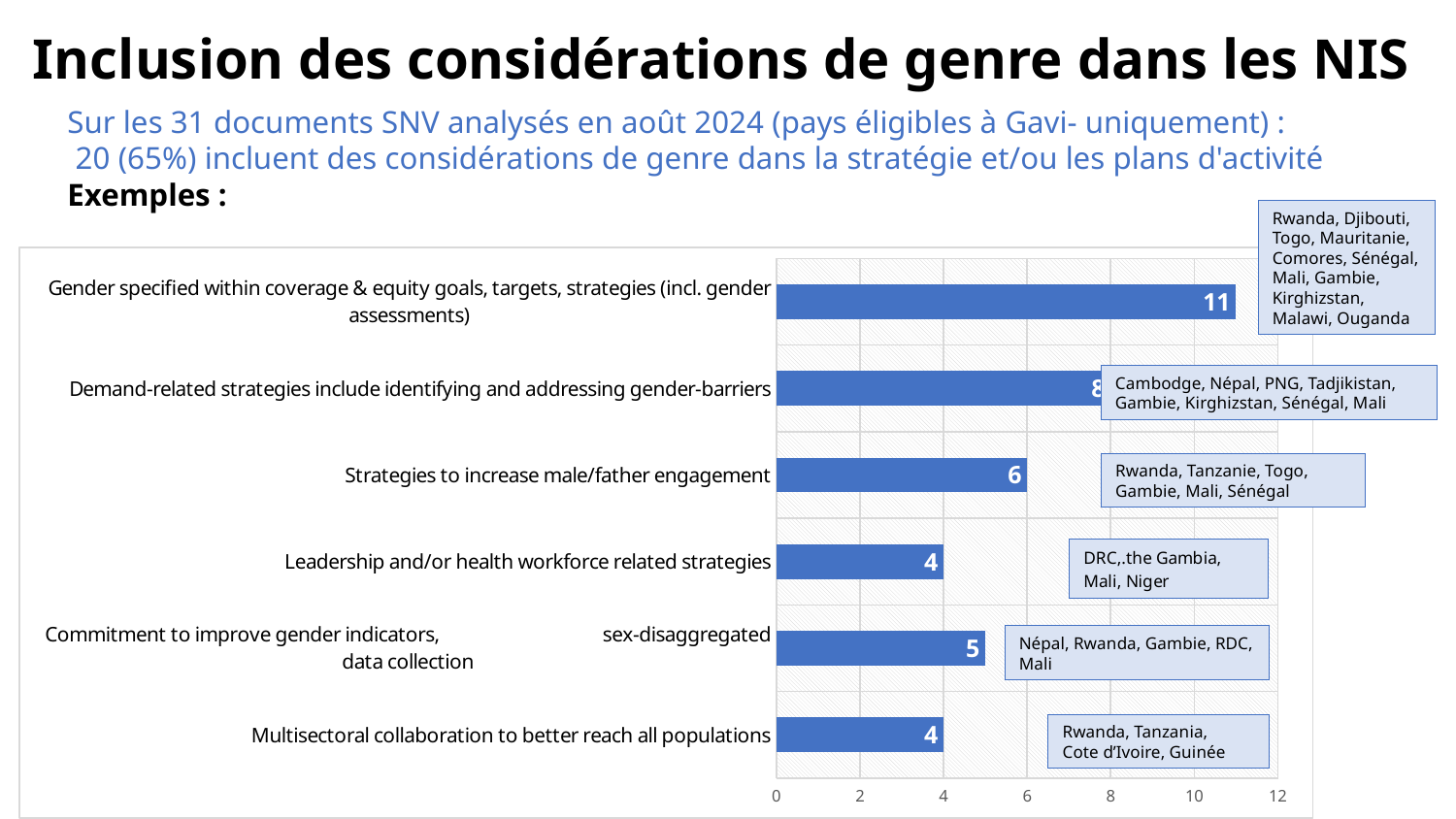
What is the difference between the value for "Gender specified within coverage & equity goals, targets, strategies (incl. gender assessments)" and the value for "Strategies to increase male/father engagement"? 5 How many categories are plotted in the bar chart? 6 What type of chart is shown on the slide? bar chart What is the value for "Multisectoral collaboration to better reach all populations"? 4 What is the value for "Commitment to improve gender indicators, sex-disaggregated data collection"? 5 What is the value for "Leadership and/or health workforce related strategies"? 4 Which category has the highest value in the chart? Gender specified within coverage & equity goals, targets, strategies (incl. gender assessments) Which is larger: the value for "Demand-related strategies include identifying and addressing gender-barriers" or the value for "Strategies to increase male/father engagement"? Demand-related strategies include identifying and addressing gender-barriers What is the value for "Strategies to increase male/father engagement"? 6 What is the value for "Gender specified within coverage & equity goals, targets, strategies (incl. gender assessments)"? 11 Is the value for "Demand-related strategies include identifying and addressing gender-barriers" greater or less than 6? greater What is the maximum value shown on the horizontal axis of the chart? 12